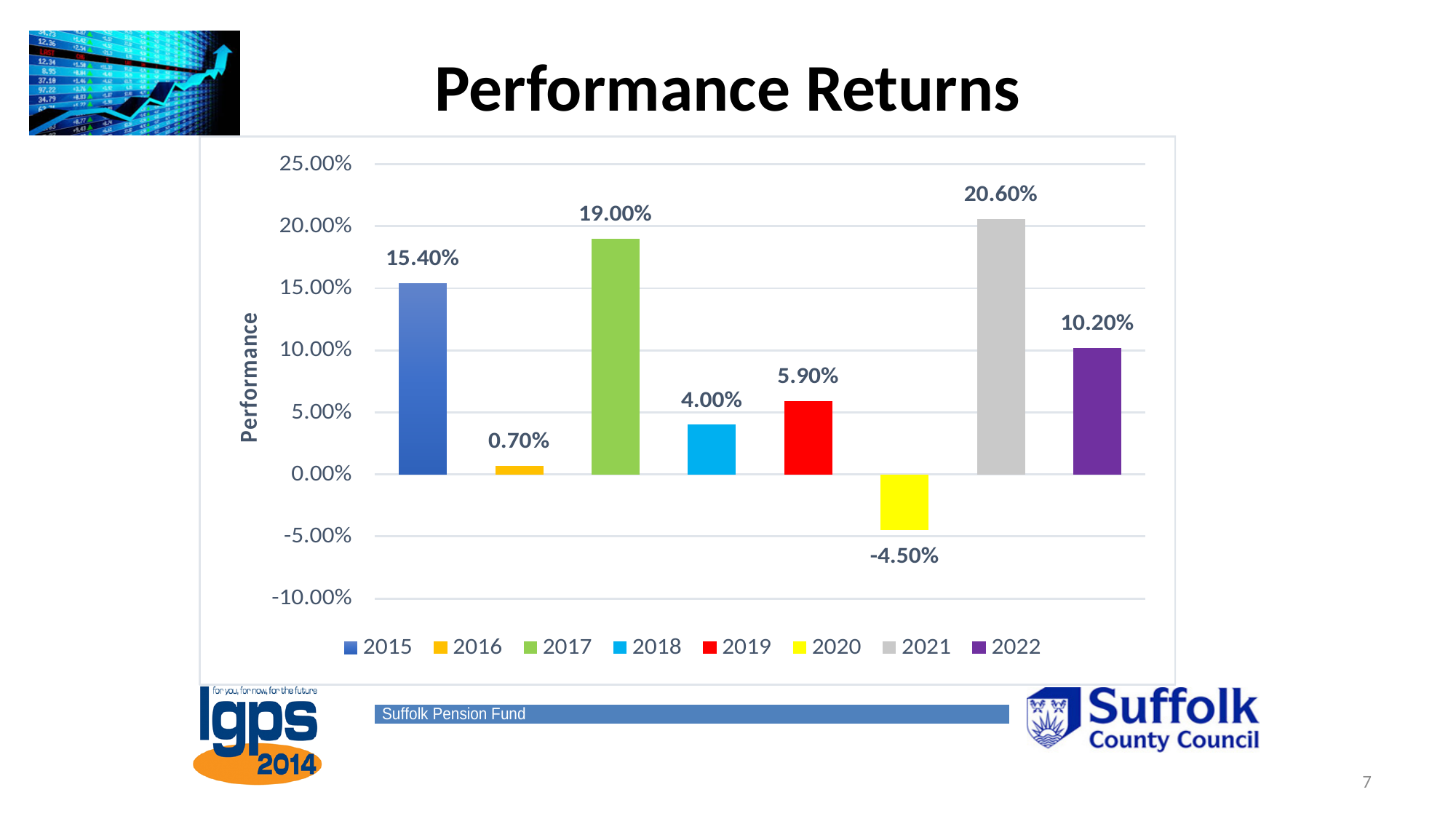
How many entries does the legend list? 8 Is the value for 2015 greater or less than 10.00%? greater What is the performance return for 2017? 19.00% What is the label on the vertical axis of the chart? Performance What is the performance return for 2022? 10.20% Which year has the lowest performance return? 2020 What is the difference between the performance returns for 2021 and 2015? 5.20% What is the performance return for 2020? -4.50% Which year has the larger performance return, 2018 or 2019? 2019 What kind of chart is shown on the slide? Bar chart Which year has the highest performance return? 2021 How many years are shown in the chart? 8